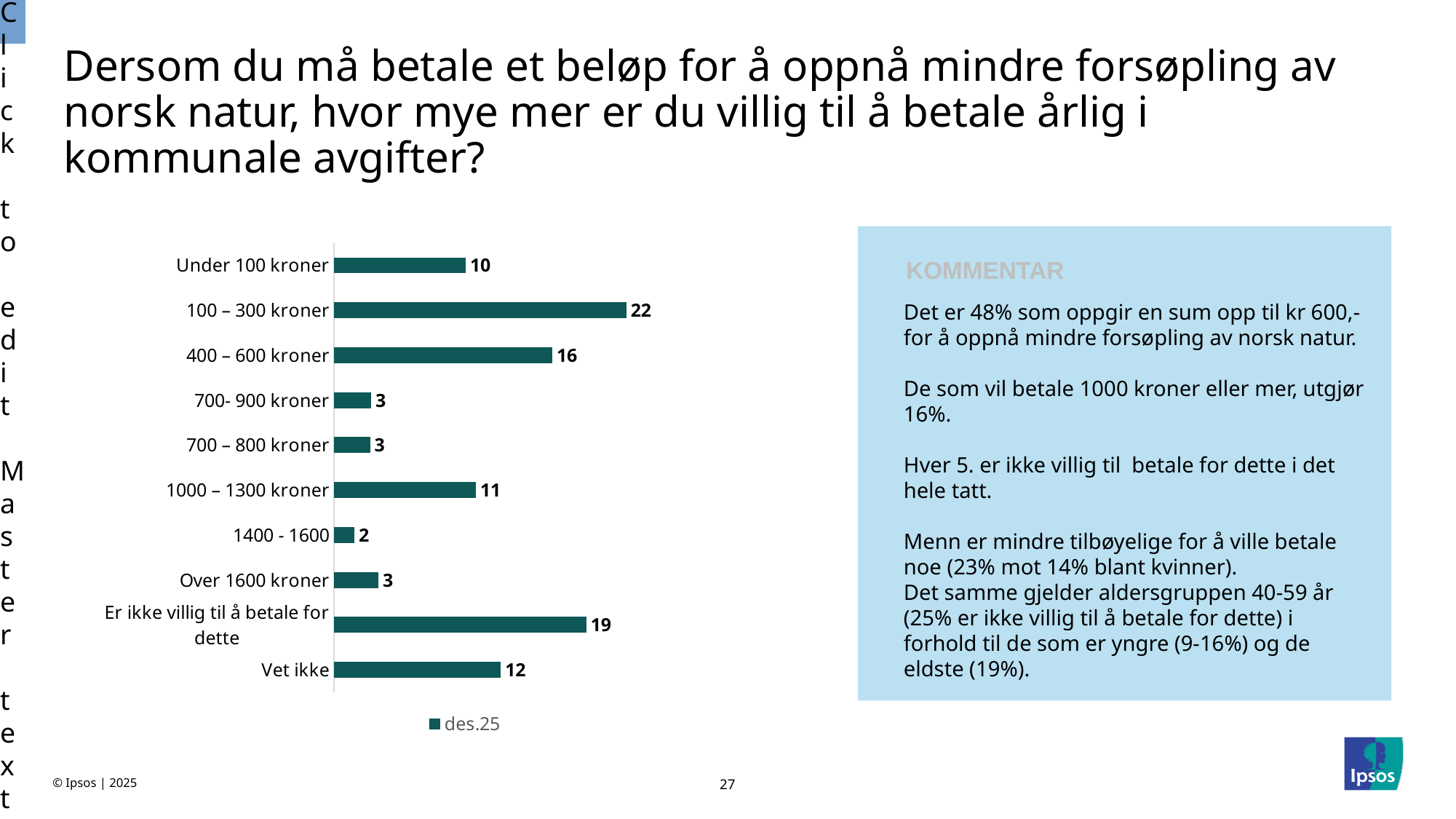
What is the difference between the values for "100 – 300 kroner" and "400 – 600 kroner"? 6 What is the value for "Er ikke villig til å betale for dette"? 19 Which category has the highest value? 100 – 300 kroner What is the value for "Vet ikke"? 12 What is the value for "100 – 300 kroner"? 22 What is the value for "1000 – 1300 kroner"? 11 How many series does the legend list? 1 What is the name of the series shown in the legend? des.25 Which is larger, the value for "Under 100 kroner" or the value for "Vet ikke"? Vet ikke Which category has the lowest value? 1400 - 1600 How many categories are shown in the chart? 10 What kind of chart is shown on the slide? Bar chart